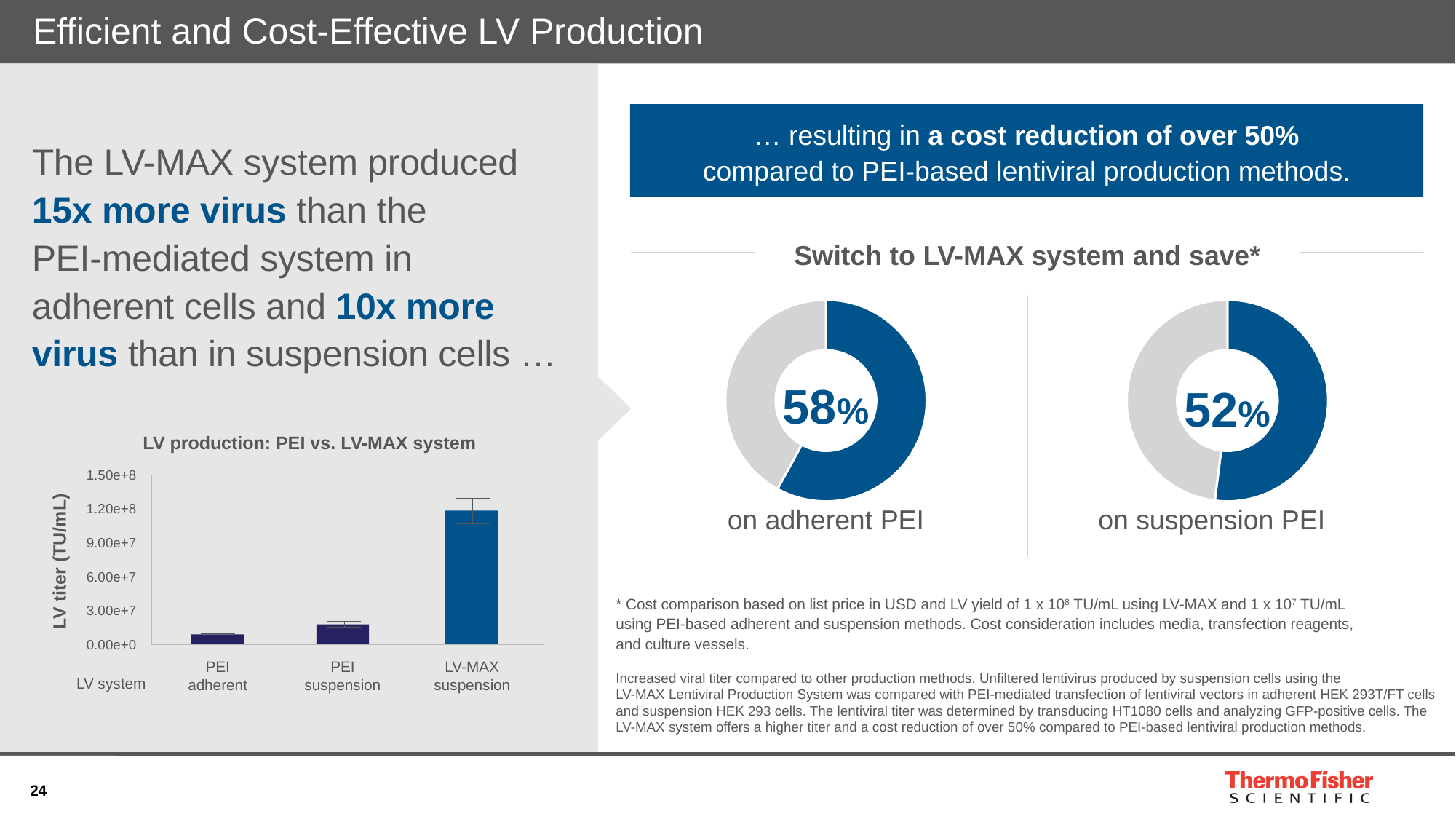
In the chart titled 'LV production: PEI vs. LV-MAX system', is the LV titer for LV-MAX suspension greater or less than 9.00e+7? greater In the chart titled 'LV production: PEI vs. LV-MAX system', which LV system has the lowest LV titer? PEI adherent In the donut chart labelled 'on adherent PEI', what percentage saving is shown? 58% In the chart titled 'LV production: PEI vs. LV-MAX system', what kind of chart is used? bar chart In the chart titled 'LV production: PEI vs. LV-MAX system', do the LV titer values rise or fall from left to right along the x axis? rise In the donut chart labelled 'on suspension PEI', what percentage saving is shown? 52% In the chart titled 'LV production: PEI vs. LV-MAX system', is the LV titer for PEI adherent greater or less than 3.00e+7? less Comparing the two donut charts under 'Switch to LV-MAX system and save*', which shows the larger saving, adherent PEI or suspension PEI? adherent PEI In the chart titled 'LV production: PEI vs. LV-MAX system', what is the label on the y axis? LV titer (TU/mL) In the chart titled 'LV production: PEI vs. LV-MAX system', how many LV systems are plotted on the x axis? 3 In the chart titled 'LV production: PEI vs. LV-MAX system', which LV system has the highest LV titer? LV-MAX suspension In the chart titled 'LV production: PEI vs. LV-MAX system', which has a higher LV titer, PEI suspension or LV-MAX suspension? LV-MAX suspension